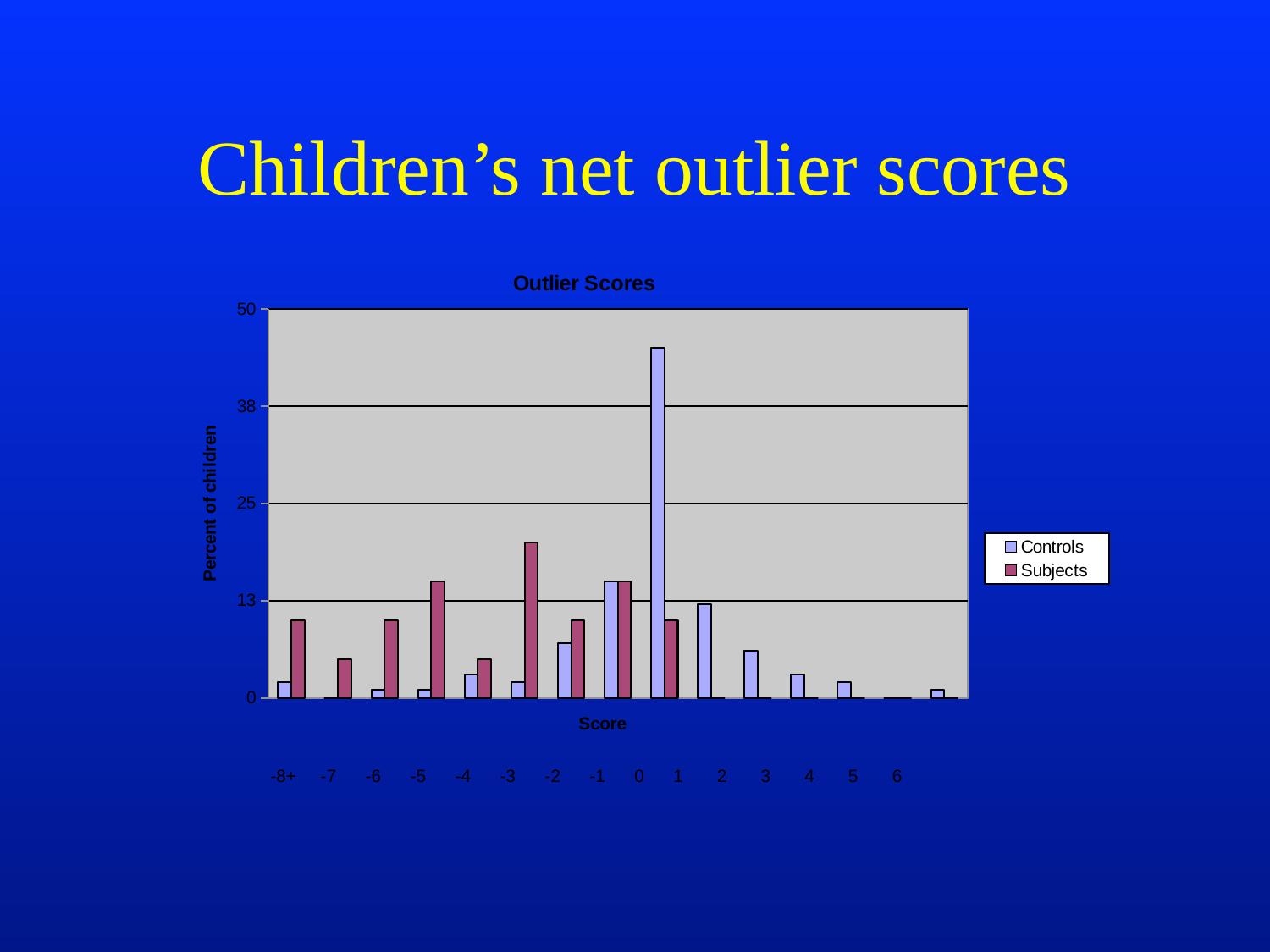
What is the label on the vertical axis? Percent of children At score -3, which series has the larger value, Controls or Subjects? Subjects Do the Controls values rise or fall from score 0 to score 6? fall Is the Subjects value at score -8+ greater or less than 13? less How many score categories are shown on the x axis? 15 At which score is the Subjects bar highest? -3 How many series does the legend list? 2 At which score is the Controls bar highest? 0 At score 2, which series has the larger value, Controls or Subjects? Controls Is the Controls value at score 0 greater or less than 38? greater Is the Subjects value at score -3 greater or less than 25? less What kind of chart is shown on the slide? Bar chart